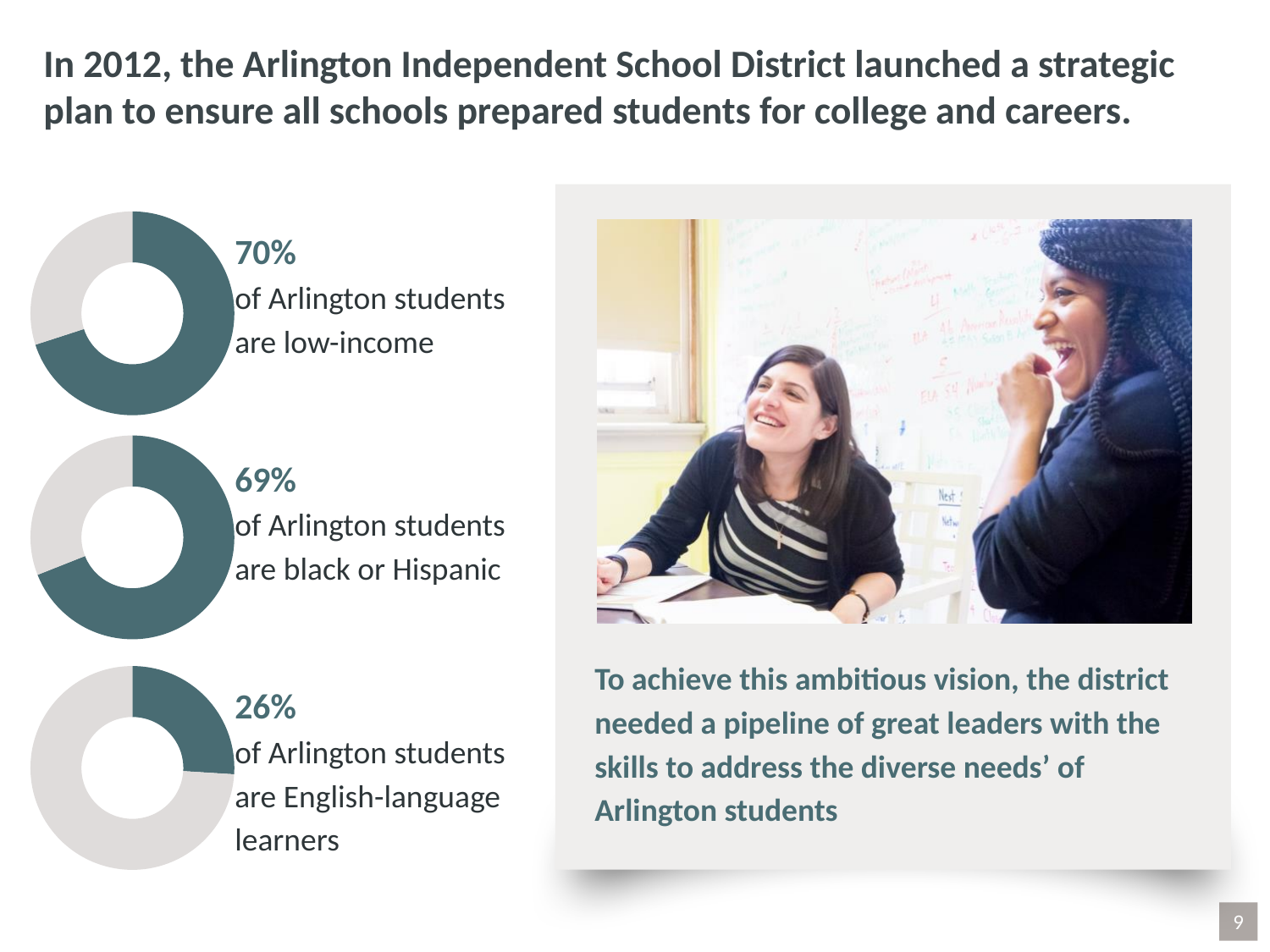
Which is larger: the share of Arlington students who are black or Hispanic, or the share who are English-language learners? Black or Hispanic In the top donut chart, what percentage of Arlington students are low-income? 70% What is the difference in percentage points between the share of low-income students and the share of English-language learners? 44 percentage points What colour is used in the donut charts to represent the stated percentage of students? Dark teal Across the three donut charts, which student group has the highest percentage? Low-income students (70%) In the bottom donut chart, what share of the ring is filled with the dark teal colour? 26% What kind of chart is used to show the three student statistics on the slide? Donut (pie) chart In the bottom donut chart, what percentage of Arlington students are English-language learners? 26% What is the difference in percentage points between the share of black or Hispanic students and the share of English-language learners? 43 percentage points In the middle donut chart, what percentage of Arlington students are black or Hispanic? 69% Across the three donut charts, which student group has the lowest percentage? English-language learners (26%) How many donut charts are shown on the slide? 3